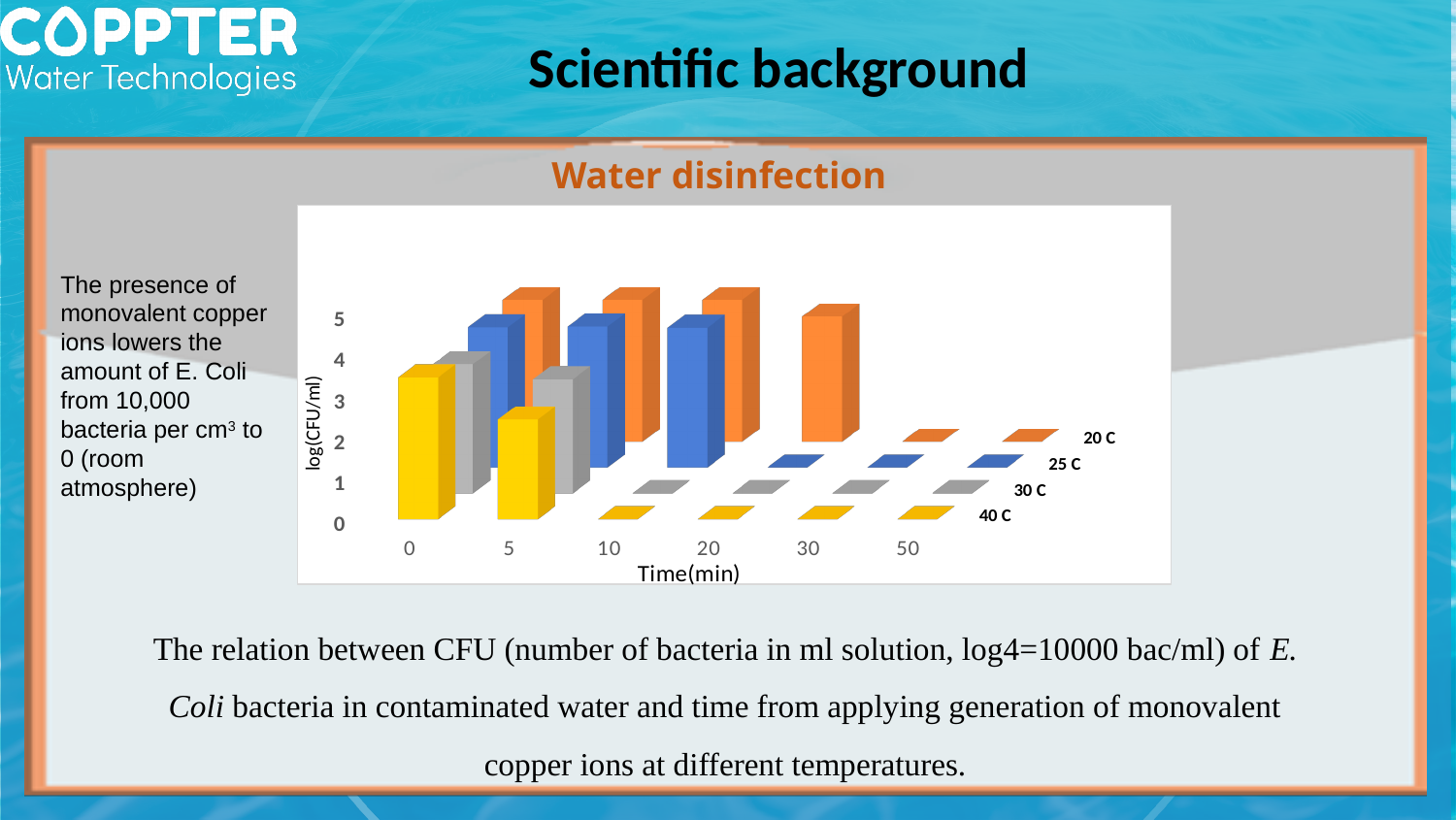
Is the value for 40 C at 10 min greater or less than 1? less How many series does the chart's legend list? 4 Is the value for 25 C at 20 min greater or less than 1? less At 30 min, which is larger: the value for 20 C or the value for 40 C? Neither; they are equal (both 0) Is the value for 20 C at 50 min greater or less than 1? less For the 40 C series, which is larger: the value at 0 min or the value at 5 min? 0 min Do the values for the 40 C series rise or fall as time increases along the x axis? fall What type of chart is shown on the slide? bar chart How many time categories are shown on the x axis of the chart? 6 What is the label of the y axis of the chart? log(CFU/ml) What is the title of the chart? Water disinfection